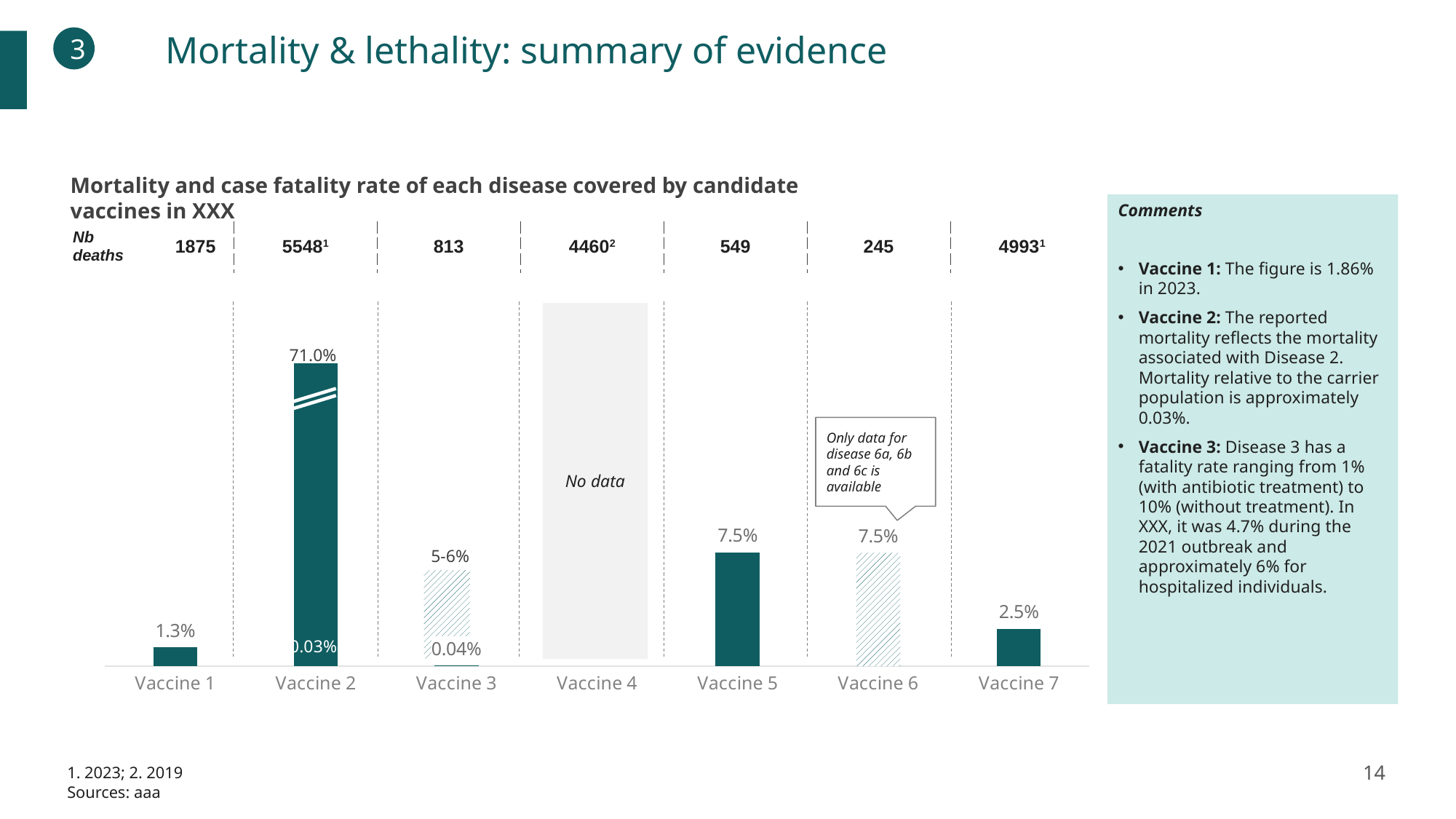
What is the case fatality rate shown for Vaccine 5? 7.5% What is the case fatality rate shown for Vaccine 1? 1.3% Which vaccine has the lowest number of deaths shown? Vaccine 6 What kind of chart is shown on the slide? Bar chart Which vaccine has the highest number of deaths shown? Vaccine 2 What is the number of deaths shown for Vaccine 3? 813 What is the case fatality rate shown for Vaccine 7? 2.5% Which vaccine has the highest case fatality rate shown on the chart? Vaccine 2 What is the number of deaths shown for Vaccine 6? 245 What is the difference between the case fatality rates of Vaccine 5 and Vaccine 7? 5.0% Which has a higher case fatality rate, Vaccine 1 or Vaccine 7? Vaccine 7 How many vaccines are shown on the x axis of the chart? 7